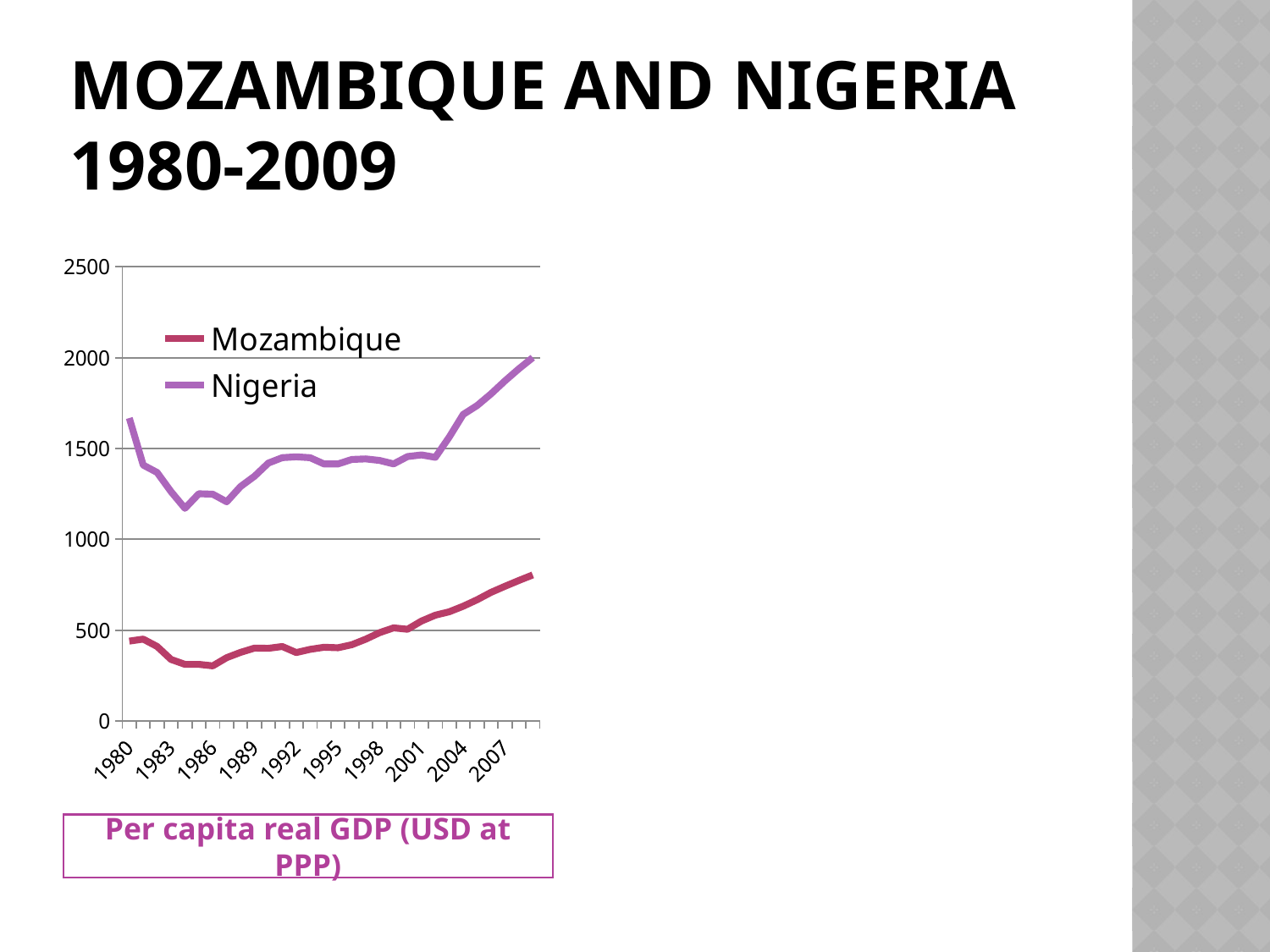
Which two countries are listed in the legend? Mozambique and Nigeria Is the value for Mozambique at the end of the period greater or less than 1000? less Is the value for Mozambique in 1986 greater or less than 500? less Is the value for Nigeria in 1980 greater or less than 1500? greater How many series does the legend list? 2 What does the caption below the chart say is being measured? Per capita real GDP (USD at PPP) Which series has the higher value in 1980, Mozambique or Nigeria? Nigeria Does the Nigeria line rise or fall from 1980 to 1983? fall Does the Mozambique line rise or fall from 1995 to the end of the period? rise What kind of chart is shown on the slide? line chart